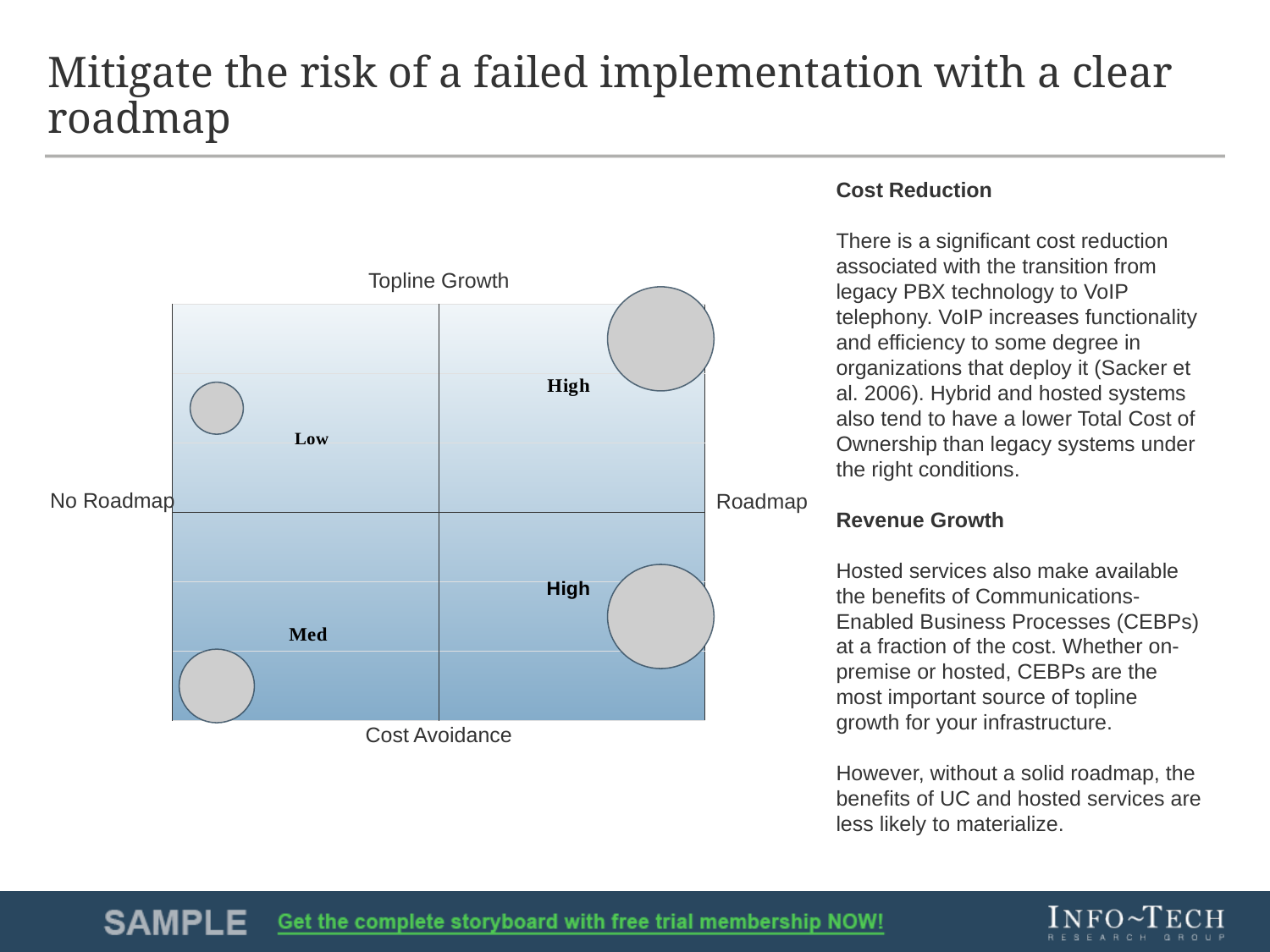
What label is shown in the bottom-left quadrant of the chart? Med What label is shown in the top-right quadrant of the chart? High What label appears at the top of the vertical axis of the chart? Topline Growth What label appears at the bottom of the vertical axis of the chart? Cost Avoidance What kind of chart is shown on the slide? Bubble chart Which quadrant contains the smallest bubble? Low (top-left) How many quadrants on the chart are labelled "High"? 2 What label is shown in the bottom-right quadrant of the chart? High Which side of the chart, No Roadmap or Roadmap, has the larger bubbles? Roadmap How many bubbles are plotted on the chart? 4 What label is shown in the top-left quadrant of the chart? Low